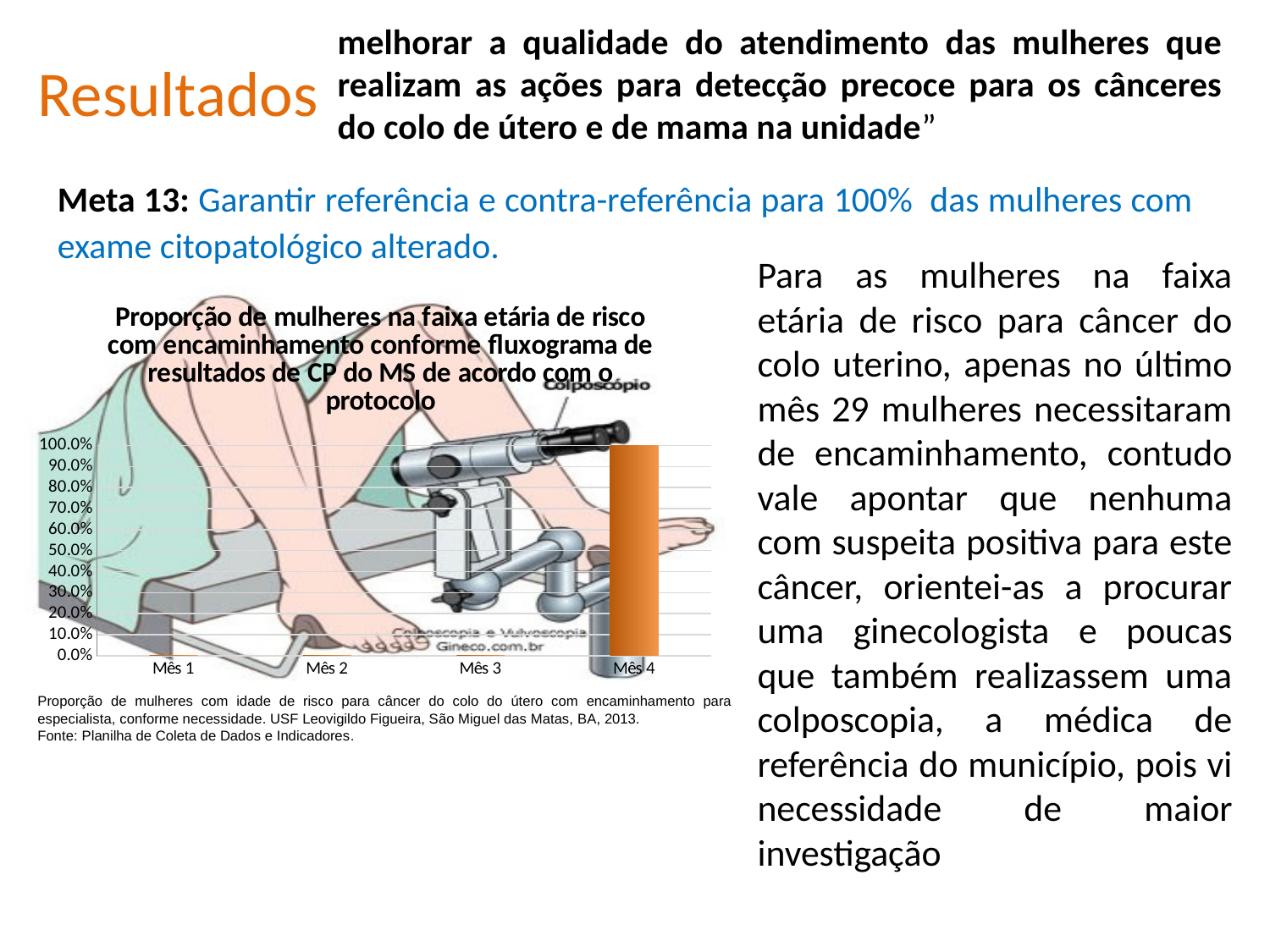
Which is larger, the value for Mês 1 or the value for Mês 4? Mês 4 What kind of chart is shown on the slide? bar chart How many categories (months) are shown on the x axis of the chart? 4 Is the value for Mês 4 greater or less than 50.0%? greater What is the highest tick value shown on the y axis of the chart? 100.0% Is the value for Mês 1 greater or less than 10.0%? less Which month has the highest value in the chart? Mês 4 Do the values rise or fall from Mês 3 to Mês 4? rise What is the value for Mês 4 in the chart? 100.0% Which is larger, the value for Mês 3 or the value for Mês 4? Mês 4 What is the label of the last category on the x axis of the chart? Mês 4